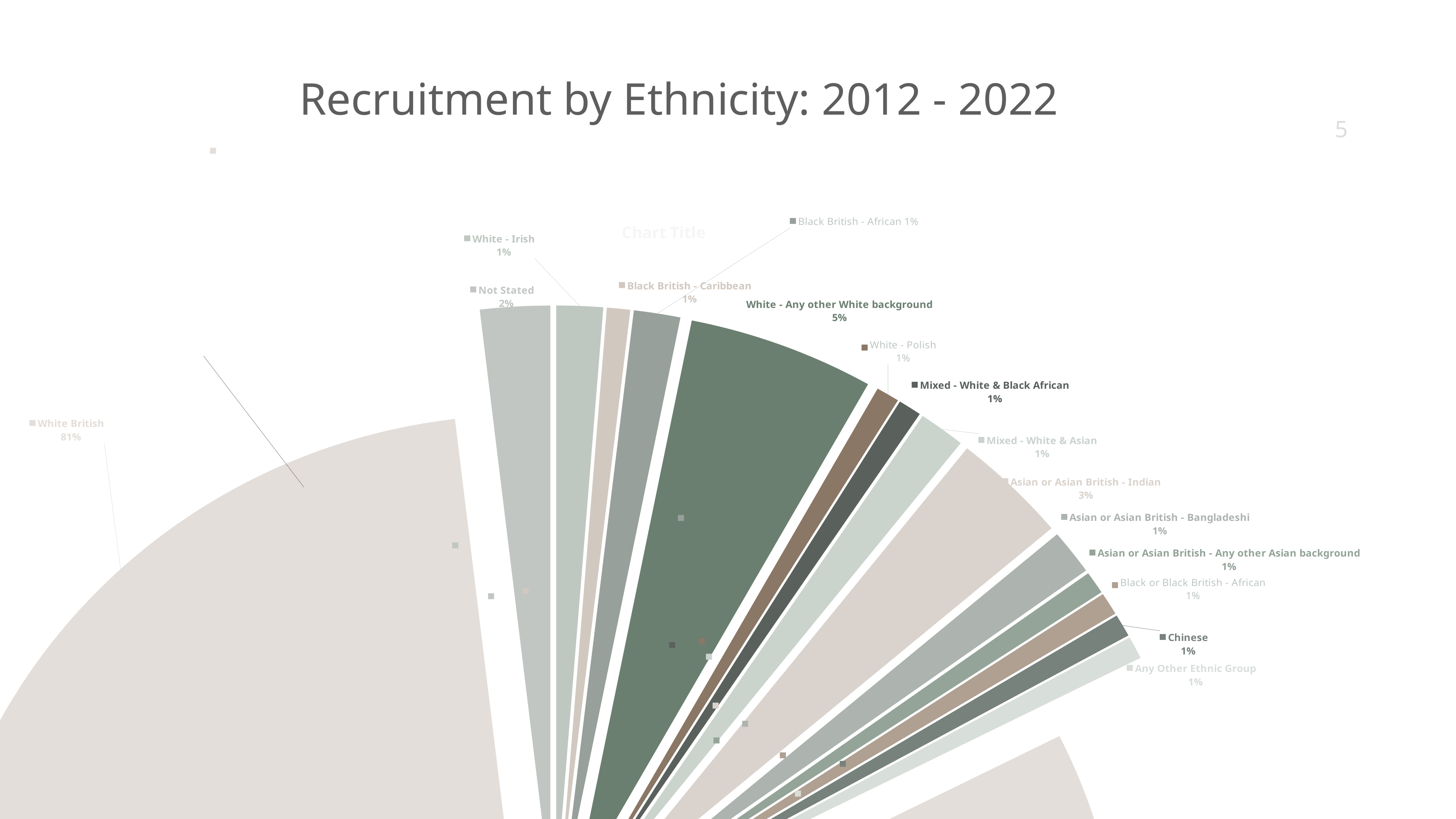
What percentage is shown for Chinese? 1% What is the difference in percentage points between White British and White - Any other White background? 76 percentage points Which ethnicity has the largest share of the pie? White British What kind of chart is shown on the slide? Pie chart Which is larger: the share for Asian or Asian British - Indian or the share for Not Stated? Asian or Asian British - Indian What is the title of the slide? Recruitment by Ethnicity: 2012 - 2022 What percentage of recruitment is shown for White British? 81% What percentage is shown for Asian or Asian British - Indian? 3% What is the difference in percentage points between Asian or Asian British - Indian and Not Stated? 1 percentage point What percentage is shown for Not Stated? 2% What percentage is shown for White - Any other White background? 5% Which is larger: the share for White - Any other White background or the share for Asian or Asian British - Indian? White - Any other White background